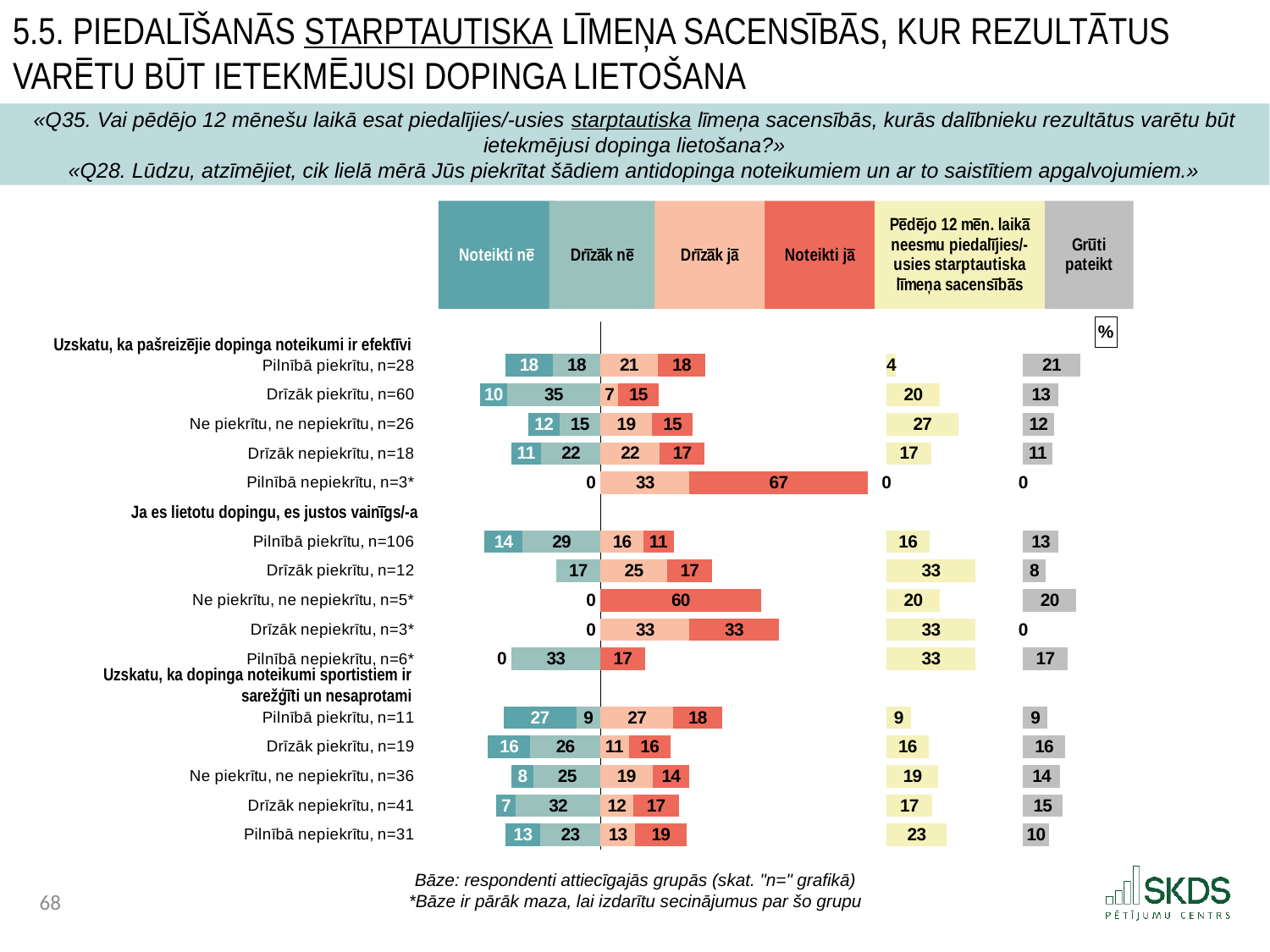
What kind of chart is shown on the slide? Stacked bar chart How many respondent rows are plotted under 'Uzskatu, ka dopinga noteikumi sportistiem ir sarežģīti un nesaprotami'? 5 How many series does the legend list? 6 What is the 'Pēdējo 12 mēn. laikā neesmu piedalījies/-usies starptautiska līmeņa sacensībās' value for 'Ne piekrītu, ne nepiekrītu, n=26' under 'Uzskatu, ka pašreizējie dopinga noteikumi ir efektīvi'? 27 What is the 'Noteikti nē' value for 'Pilnībā piekrītu, n=11' under 'Uzskatu, ka dopinga noteikumi sportistiem ir sarežģīti un nesaprotami'? 27 What is the 'Grūti pateikt' value for 'Pilnībā piekrītu, n=106' under 'Ja es lietotu dopingu, es justos vainīgs/-a'? 13 Which is larger for 'Drīzāk nepiekrītu, n=41' under 'Uzskatu, ka dopinga noteikumi sportistiem ir sarežģīti un nesaprotami': 'Drīzāk nē' or 'Noteikti jā'? Drīzāk nē What unit symbol is shown at the top right of the chart area? % What is the 'Noteikti jā' value for 'Pilnībā nepiekrītu, n=3*' under 'Uzskatu, ka pašreizējie dopinga noteikumi ir efektīvi'? 67 What is the 'Drīzāk nē' value for 'Drīzāk piekrītu, n=60' under 'Uzskatu, ka pašreizējie dopinga noteikumi ir efektīvi'? 35 What is the difference between the 'Drīzāk nē' value (35) and the 'Drīzāk jā' value (7) for 'Drīzāk piekrītu, n=60' under 'Uzskatu, ka pašreizējie dopinga noteikumi ir efektīvi'? 28